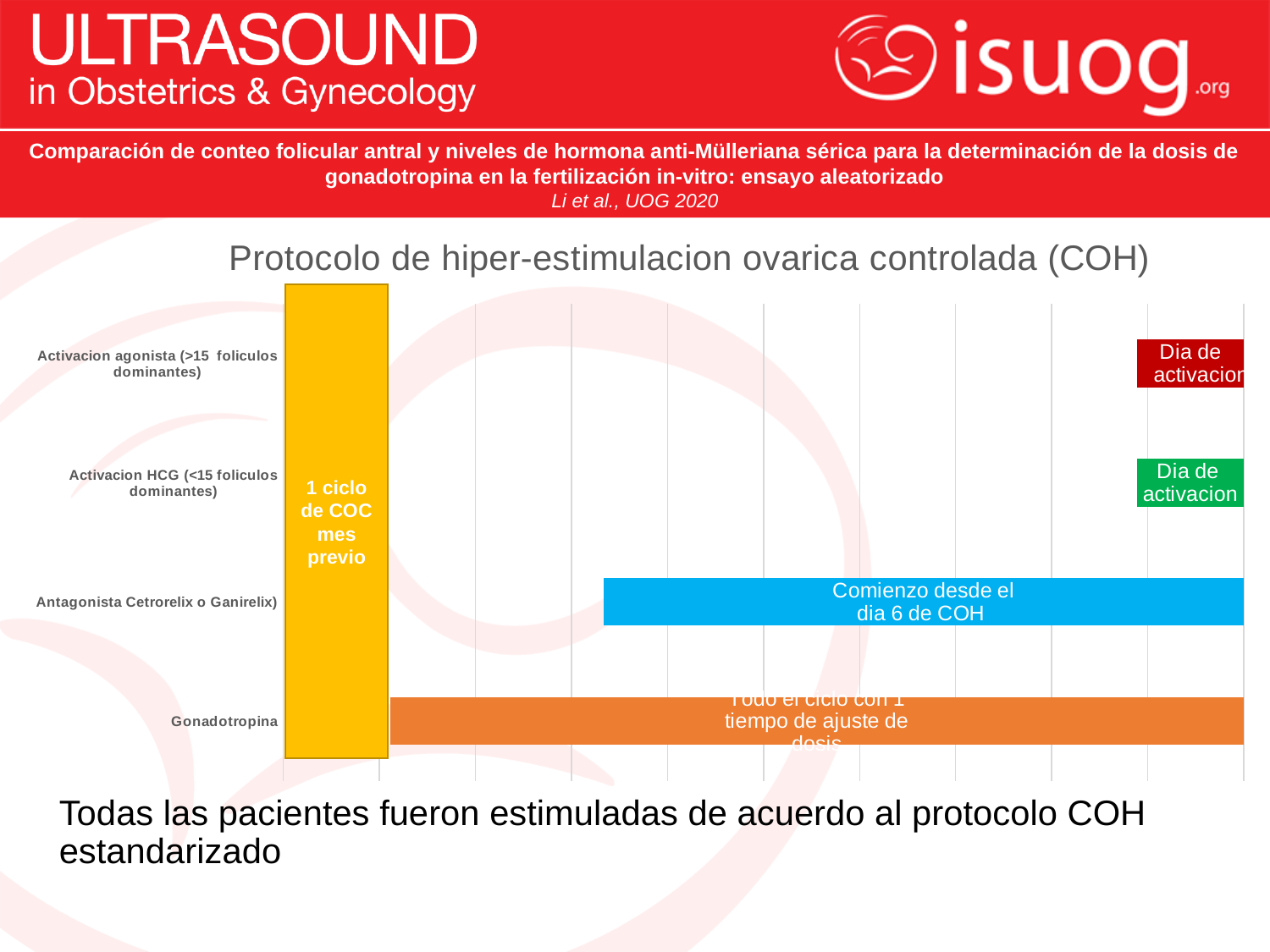
What is the title of the chart? Protocolo de hiper-estimulacion ovarica controlada (COH) Which bar is longer, the one for Gonadotropina or the one for Antagonista Cetrorelix o Ganirelix? Gonadotropina Which bar is longer, the one for Gonadotropina or the one for Activacion agonista (>15 foliculos dominantes)? Gonadotropina How many categories are listed on the vertical axis of the chart? 4 Which category has the longest bar in the chart? Gonadotropina What kind of chart is shown on the slide? Bar chart What text is printed on the bar for Antagonista Cetrorelix o Ganirelix? Comienzo desde el dia 6 de COH Which bar is longer, the one for Antagonista Cetrorelix o Ganirelix or the one for Activacion HCG (<15 foliculos dominantes)? Antagonista Cetrorelix o Ganirelix